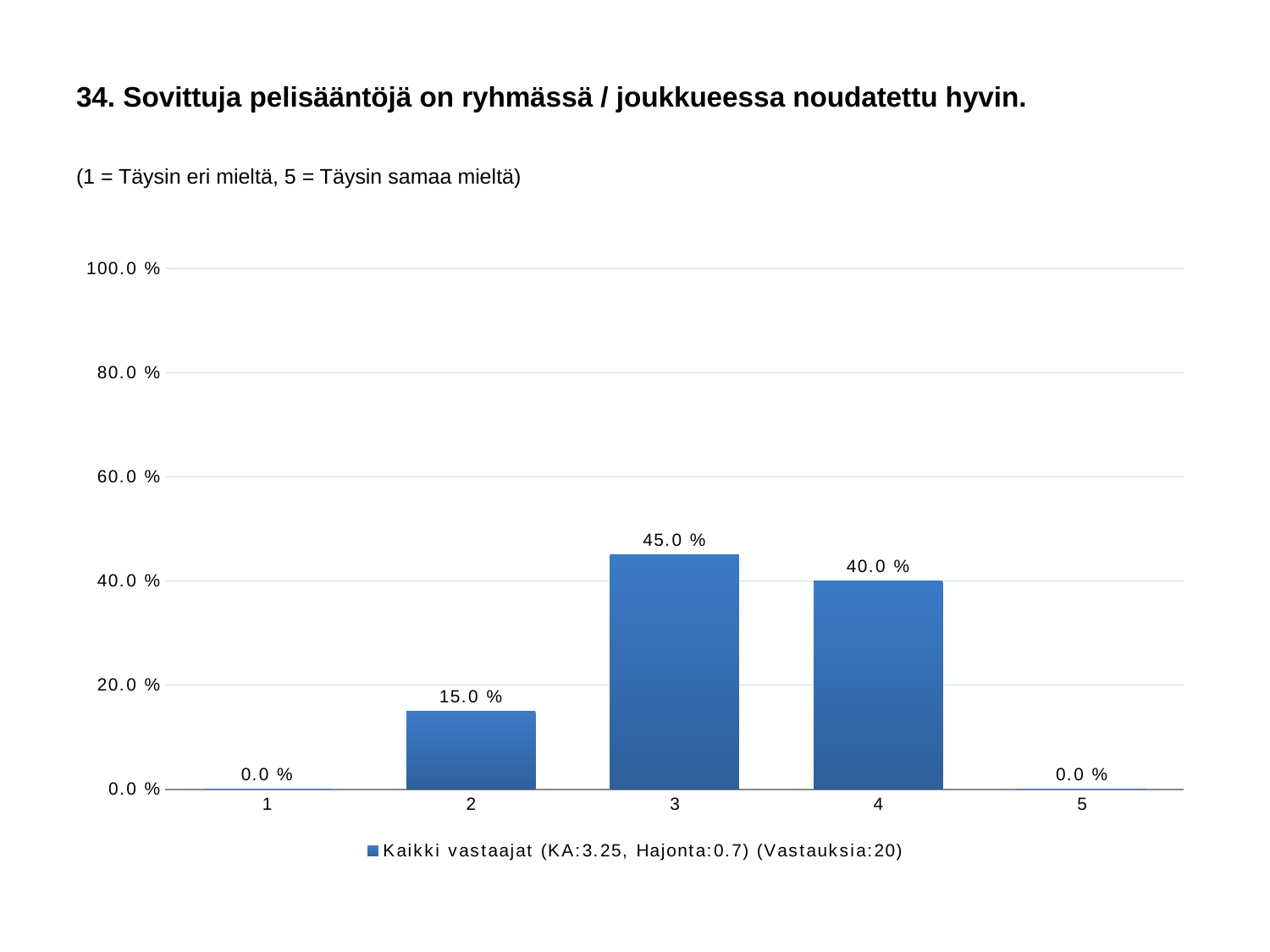
What is the value for category 3? 45.0 % What is the difference between the values for categories 3 and 4? 5.0 % What is the number of responses (Vastauksia) given in the legend? 20 What is the value for category 5? 0.0 % Which category has the highest value? 3 How many categories are shown on the x axis? 5 Which is larger, the value for category 2 or the value for category 4? 4 What is the difference between the values for categories 4 and 2? 25.0 % What is the value for category 2? 15.0 % What kind of chart is shown on the slide? bar chart What is the value for category 4? 40.0 % How many series does the legend list? 1